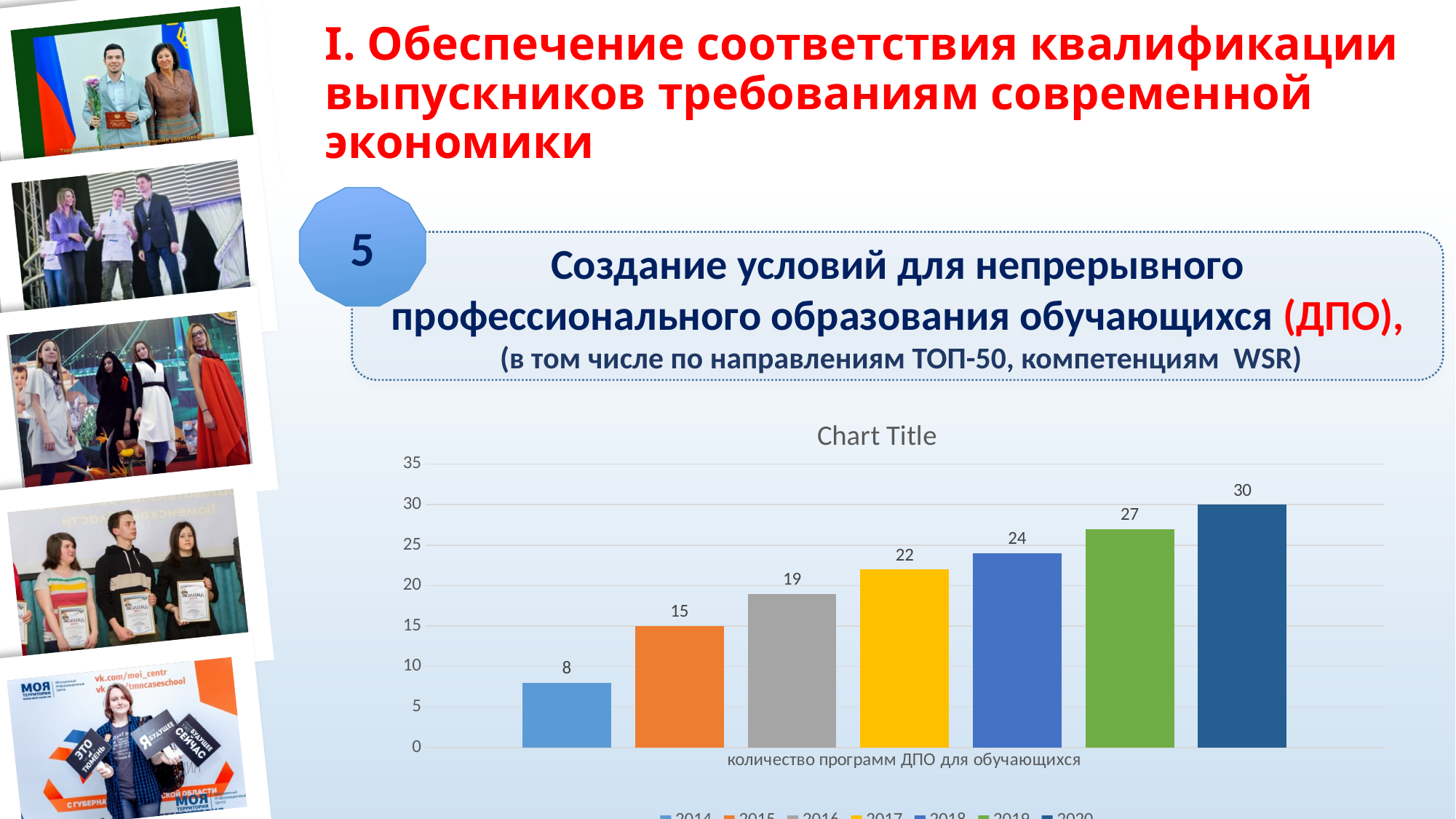
What is the difference between the values for 2020 and 2014? 22 Which year has the highest value in the chart? 2020 How many series does the legend list? 7 Do the values rise or fall from 2014 to 2020? rise What is the value for 2020 in the chart? 30 What is the value for 2017 in the chart? 22 Which year has the lowest value in the chart? 2014 What type of chart is shown on the slide? bar chart What is the value for 2014 in the chart? 8 What is the difference between the values for 2019 and 2018? 3 Which is larger, the value for 2016 or the value for 2015? 2016 What is the title shown above the chart? Chart Title